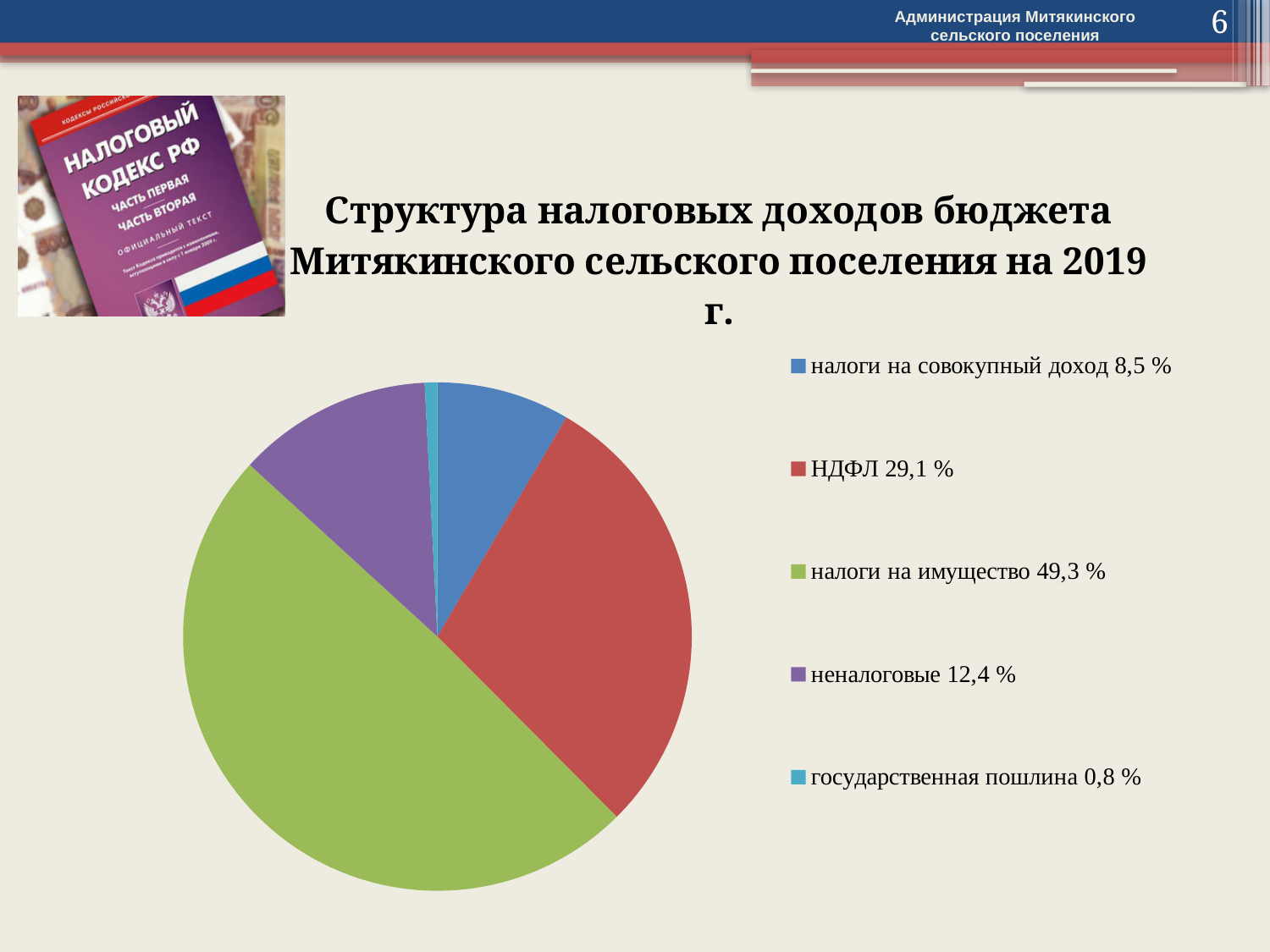
What colour is the slice for налоги на совокупный доход? blue What share of the pie is неналоговые? 12,4 % Which category has the largest slice of the pie? налоги на имущество What is the difference in percentage points between налоги на имущество and НДФЛ? 20,2 What share of the pie is НДФЛ? 29,1 % What share of the pie is налоги на имущество? 49,3 % What kind of chart is shown on the slide? pie chart Which is larger: НДФЛ or неналоговые? НДФЛ What is the title of the chart? Структура налоговых доходов бюджета Митякинского сельского поселения на 2019 г. Which category has the smallest slice of the pie? государственная пошлина How many slices does the pie chart have? 5